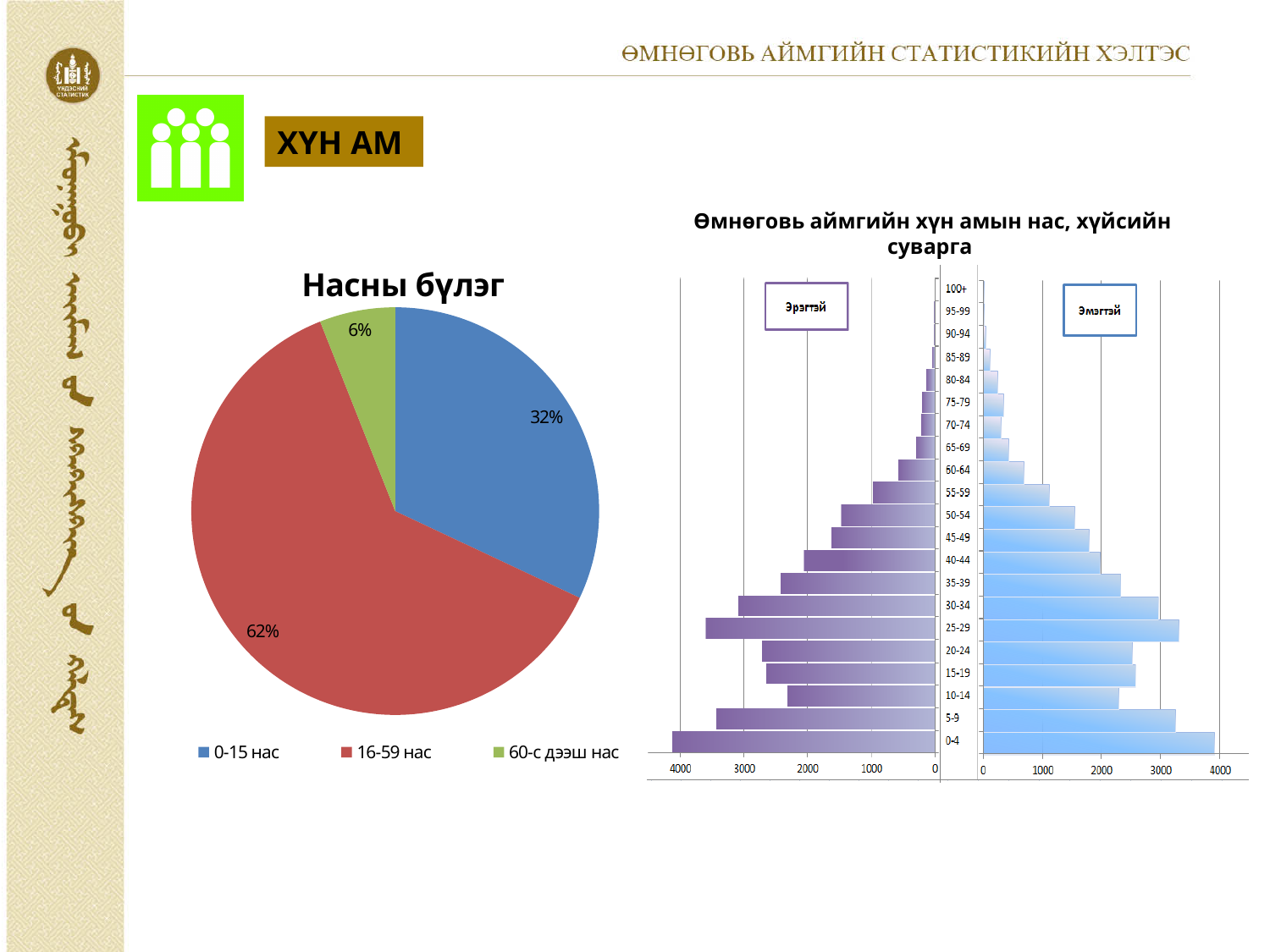
In the pie chart 'Насны бүлэг', what share does the '16-59 нас' group have? 62% In the pie chart 'Насны бүлэг', what share does the '0-15 нас' group have? 32% How many categories does the pie chart 'Насны бүлэг' show? 3 How many series does the chart 'Өмнөговь аймгийн хүн амын нас, хүйсийн суварга' show? 2 In the chart 'Өмнөговь аймгийн хүн амын нас, хүйсийн суварга', which age group has the largest 'Эмэгтэй' value? 0-4 In the pie chart 'Насны бүлэг', which age group has the smallest share? 60-с дээш нас In the chart 'Өмнөговь аймгийн хүн амын нас, хүйсийн суварга', is the 'Эрэгтэй' value for the 0-4 age group greater or less than 3000? greater What kind of chart is the chart titled 'Өмнөговь аймгийн хүн амын нас, хүйсийн суварга'? Bar chart In the pie chart 'Насны бүлэг', which age group has the largest share? 16-59 нас What kind of chart is the chart titled 'Насны бүлэг'? Pie chart In the pie chart 'Насны бүлэг', what share does the '60-с дээш нас' group have? 6% In the pie chart 'Насны бүлэг', how many percentage points larger is the '16-59 нас' share than the '0-15 нас' share? 30 percentage points